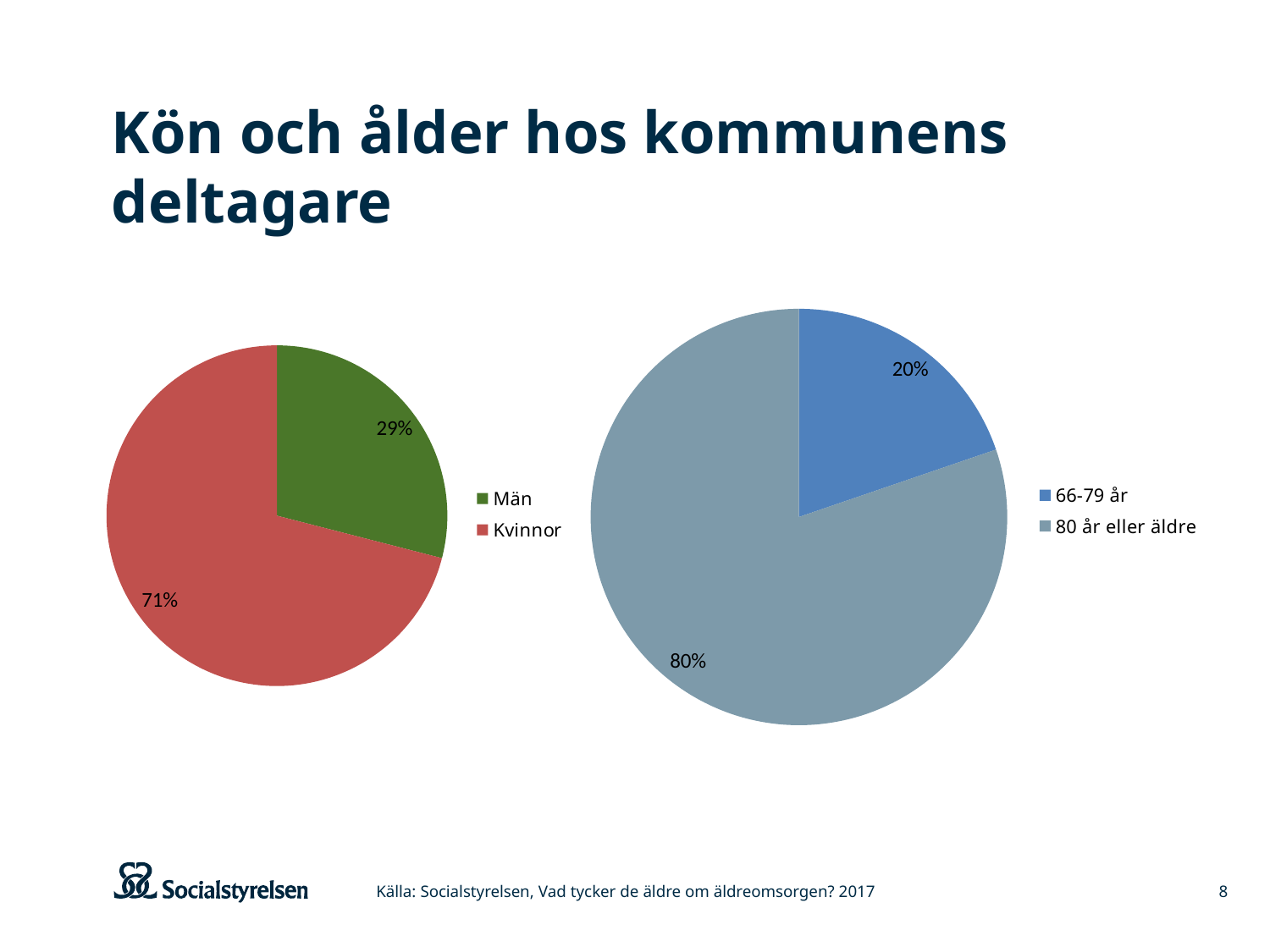
In the right pie chart (age groups), what share is shown for 66-79 år? 20% In the left pie chart (Män/Kvinnor), which category has the largest slice? Kvinnor In the right pie chart (age groups), what is the difference in percentage points between 80 år eller äldre and 66-79 år? 60 In the right pie chart (age groups), what share is shown for 80 år eller äldre? 80% What type of chart is the right chart (age groups)? Pie chart In the right pie chart (age groups), what colour is the slice for 66-79 år? Blue In the left pie chart (Män/Kvinnor), what is the difference in percentage points between Kvinnor and Män? 42 How many slices does the left pie chart (Män/Kvinnor) have? 2 In the right pie chart (age groups), which category has the smallest slice? 66-79 år In the right pie chart (age groups), which is larger: 66-79 år or 80 år eller äldre? 80 år eller äldre In the left pie chart (Män/Kvinnor), what share is shown for Män? 29% In the left pie chart (Män/Kvinnor), what share is shown for Kvinnor? 71%